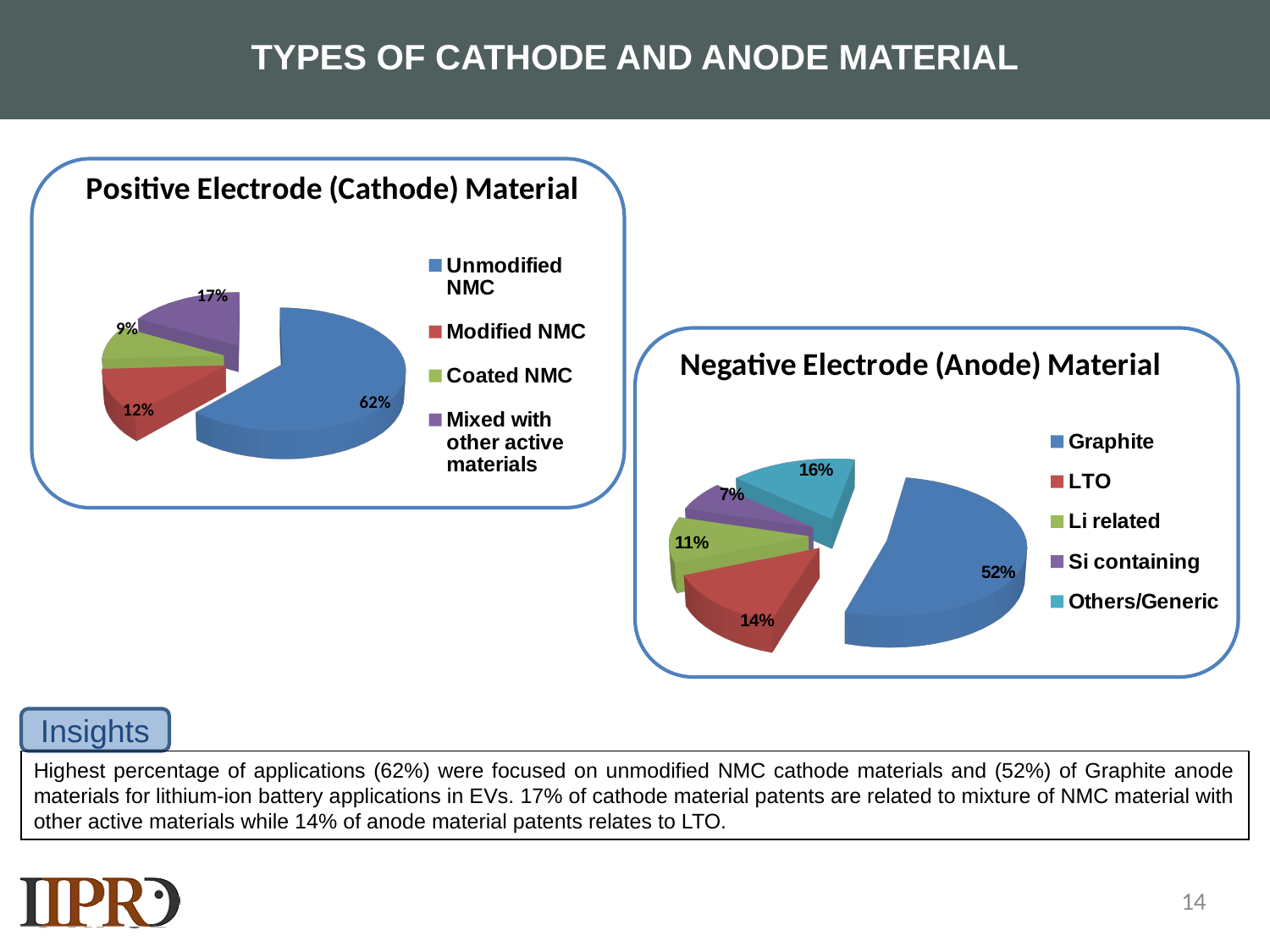
In the Negative Electrode (Anode) Material chart, which is larger, Others/Generic or Li related? Others/Generic In the Negative Electrode (Anode) Material chart, what is the difference between Graphite and Others/Generic? 36% In the Positive Electrode (Cathode) Material chart, which category has the smallest share? Coated NMC In the Positive Electrode (Cathode) Material chart, what percentage is Coated NMC? 9% How many categories does the legend of the Negative Electrode (Anode) Material chart list? 5 In the Positive Electrode (Cathode) Material chart, what is the difference between Mixed with other active materials and Modified NMC? 5% In the Negative Electrode (Anode) Material chart, what percentage is LTO? 14% In the Negative Electrode (Anode) Material chart, what percentage is Si containing? 7% How many categories does the Positive Electrode (Cathode) Material chart show? 4 What type of chart is the Negative Electrode (Anode) Material chart? Pie chart In the Negative Electrode (Anode) Material chart, which category has the largest share? Graphite In the Positive Electrode (Cathode) Material chart, what percentage is Unmodified NMC? 62%